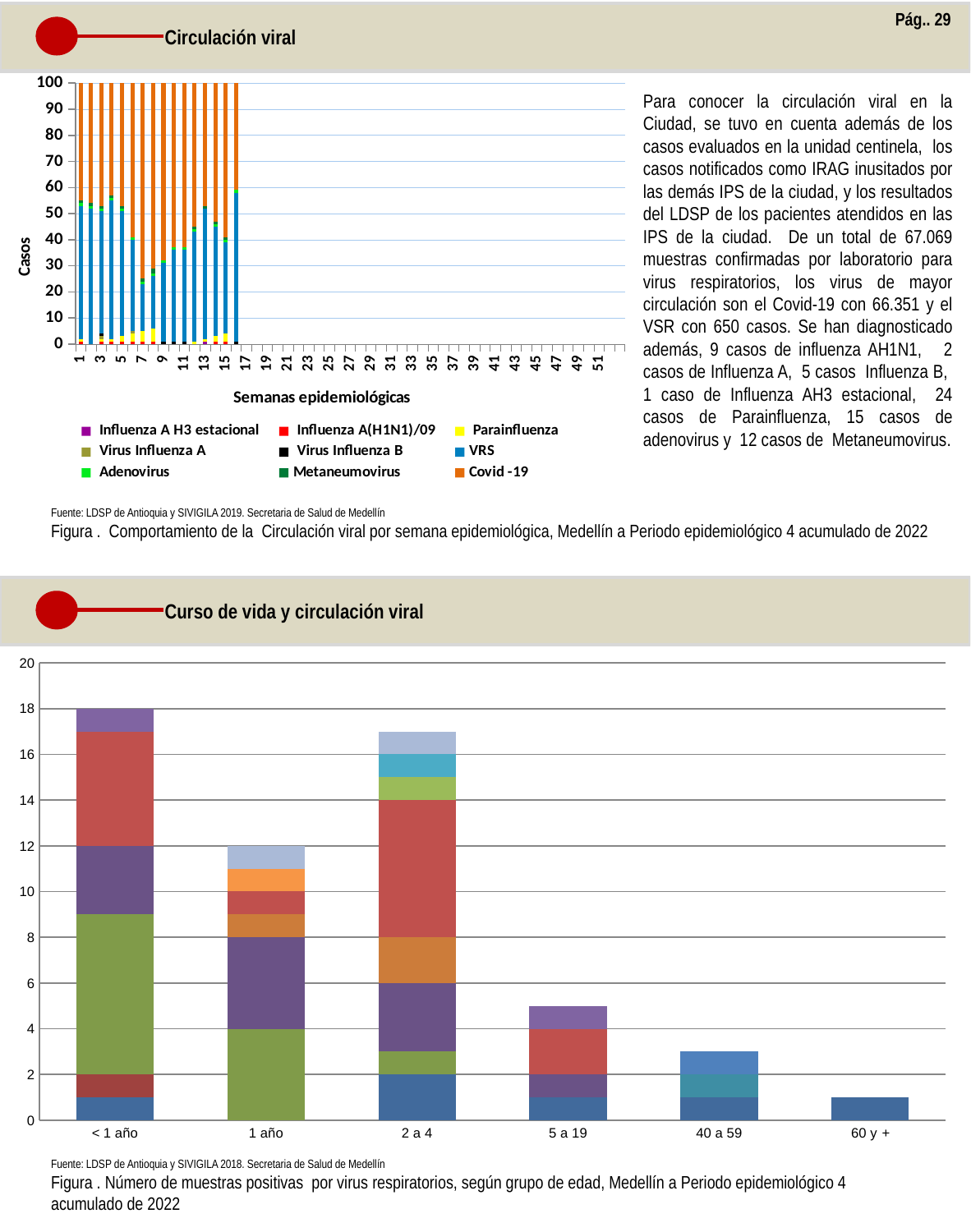
What kind of chart is the top chart (Circulación viral)? Stacked bar chart On the bottom chart (Curso de vida y circulación viral), which age group has the highest total bar? < 1 año On the bottom chart (Curso de vida y circulación viral), what is the total height of the bar for < 1 año? 18 How many series does the legend of the top chart (Circulación viral) list? 9 How many age-group categories are shown on the bottom chart (Curso de vida y circulación viral)? 6 What is the y-axis title of the top chart (Circulación viral)? Casos On the bottom chart (Curso de vida y circulación viral), what is the difference between the total for < 1 año and the total for 1 año? 6 What kind of chart is the bottom chart (Curso de vida y circulación viral)? Stacked bar chart On the bottom chart (Curso de vida y circulación viral), what is the total height of the bar for 1 año? 12 On the bottom chart (Curso de vida y circulación viral), is the total for 2 a 4 greater or less than 16? greater What is the x-axis title of the top chart (Circulación viral)? Semanas epidemiológicas On the bottom chart (Curso de vida y circulación viral), which age group has the lowest total bar? 60 y +